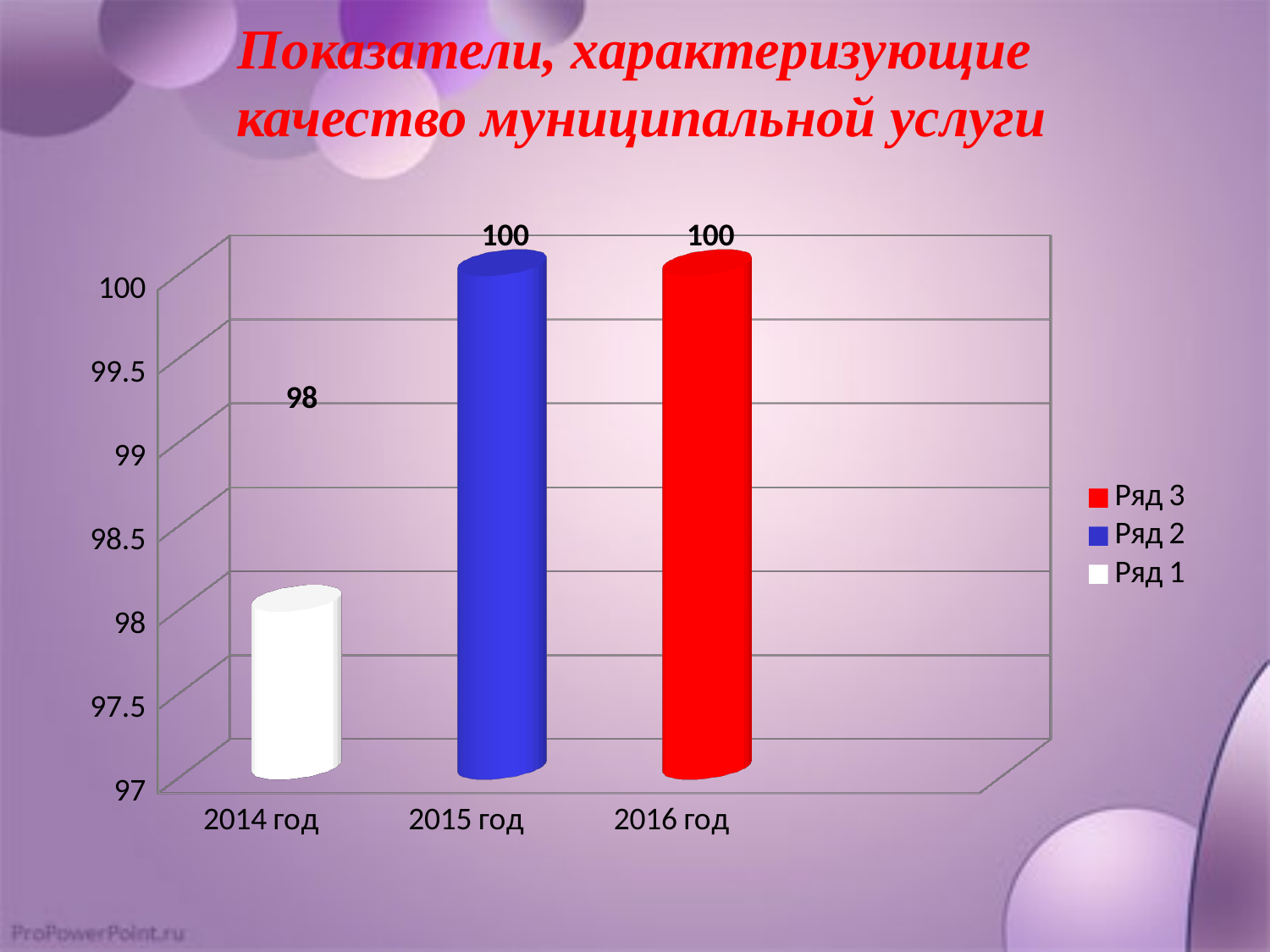
Which is larger, the value for 2014 год or the value for 2016 год? 2016 год Do the values rise or fall from 2014 год to 2015 год? rise Is the value for 2014 год greater or less than 99? less What is the value for 2014 год? 98 How many series does the legend list? 3 What is the difference between the values for 2015 год and 2014 год? 2 What kind of chart is shown on the slide? bar chart How many categories are shown on the x axis? 3 Which year has the lowest value? 2014 год What is the value for 2015 год? 100 What is the value for 2016 год? 100 What colour is the bar for 2016 год? red